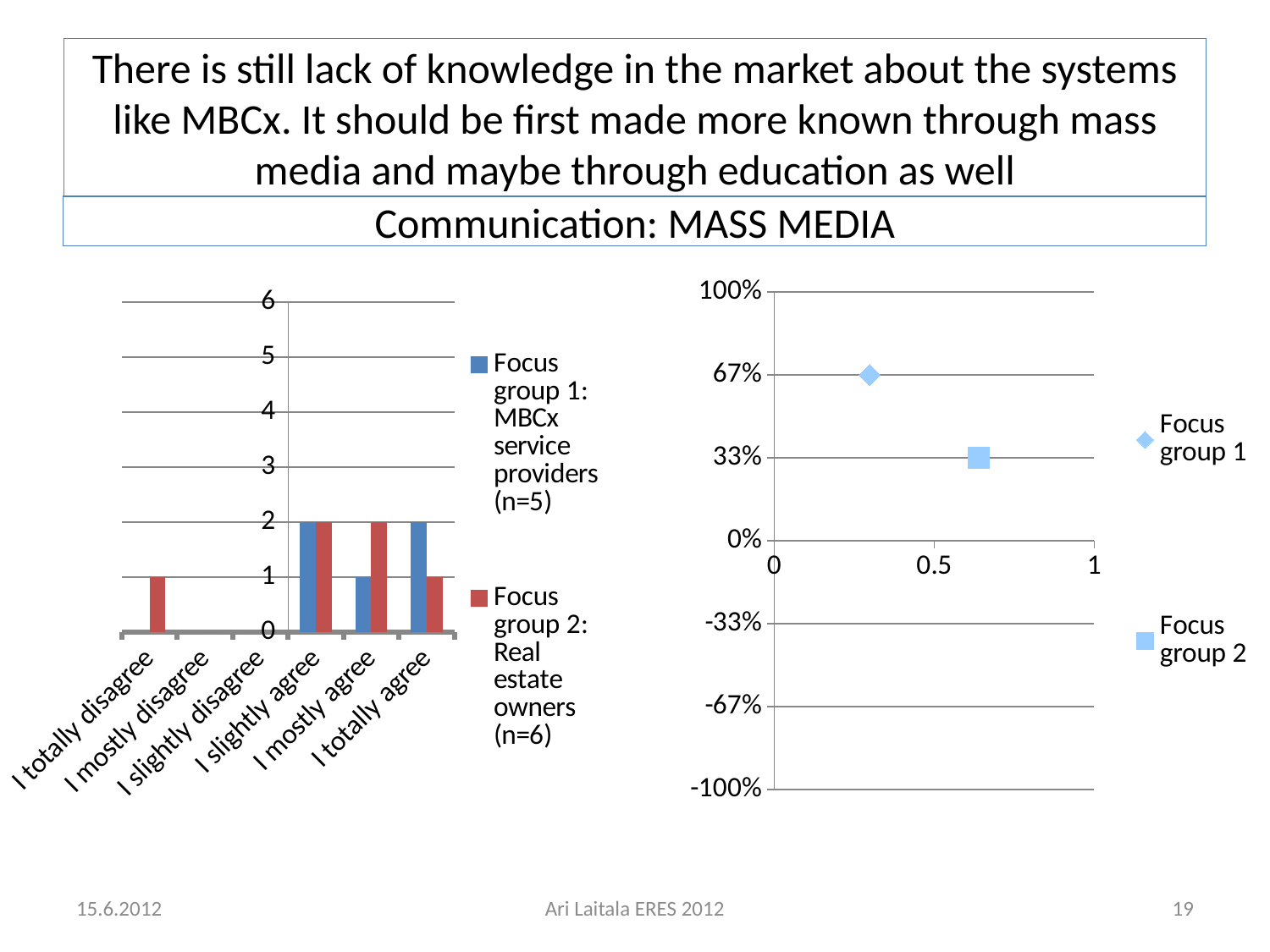
What kind of chart is the chart on the left of the slide? bar chart On the left bar chart, what is the value for Focus group 2: Real estate owners (n=6) for 'I mostly agree'? 2 On the right scatter chart, what is the y-axis value of the Focus group 1 point? 67% On the right scatter chart, is the x-axis value of the Focus group 1 point greater or less than 0.5? less On the left bar chart, how many categories are shown on the x axis? 6 On the left bar chart, what is the value for Focus group 1: MBCx service providers (n=5) for 'I mostly agree'? 1 On the right scatter chart, what is the y-axis value of the Focus group 2 point? 33% On the left bar chart, which of the two series has the larger value for 'I totally agree'? Focus group 1: MBCx service providers (n=5) On the left bar chart, what is the difference between Focus group 2 and Focus group 1 for 'I mostly agree'? 1 On the left bar chart, what is the value for Focus group 1: MBCx service providers (n=5) for 'I totally agree'? 2 On the left bar chart, how many series does the legend list? 2 On the left bar chart, what is the value for Focus group 2: Real estate owners (n=6) for 'I totally disagree'? 1